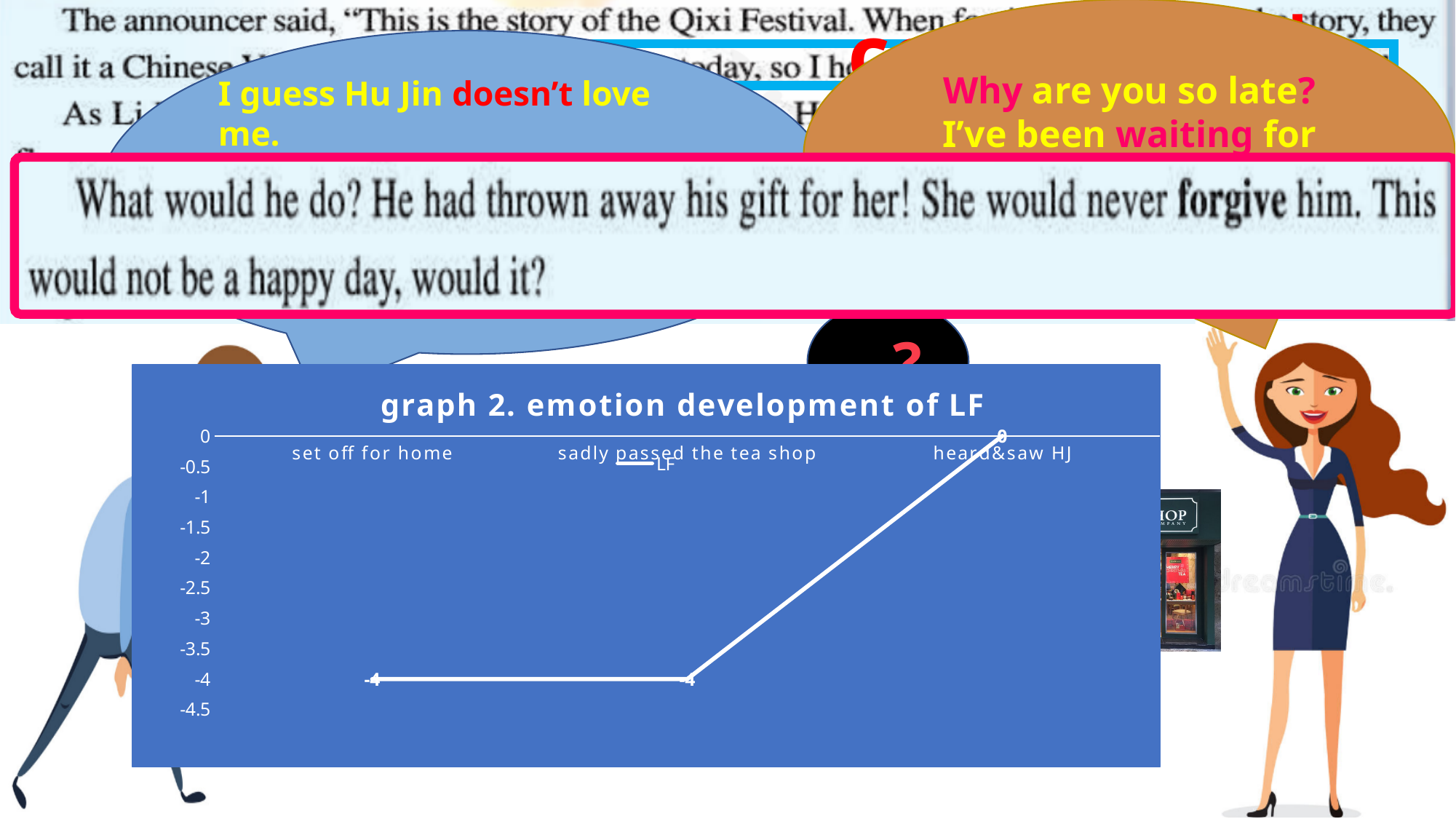
What kind of chart is shown on the slide? line chart Which category has the highest value? heard&saw HJ What is the difference between the value for "heard&saw HJ" and the value for "sadly passed the tea shop"? 4 What is the value for "sadly passed the tea shop"? -4 What is the name of the series in the legend? LF What is the value for "set off for home"? -4 What is the value for "heard&saw HJ"? 0 How many series does the legend list? 1 What is the title of the chart? graph 2. emotion development of LF Do the values rise or fall from "sadly passed the tea shop" to "heard&saw HJ"? rise Which is larger, the value for "heard&saw HJ" or the value for "set off for home"? heard&saw HJ How many categories are plotted on the x axis? 3